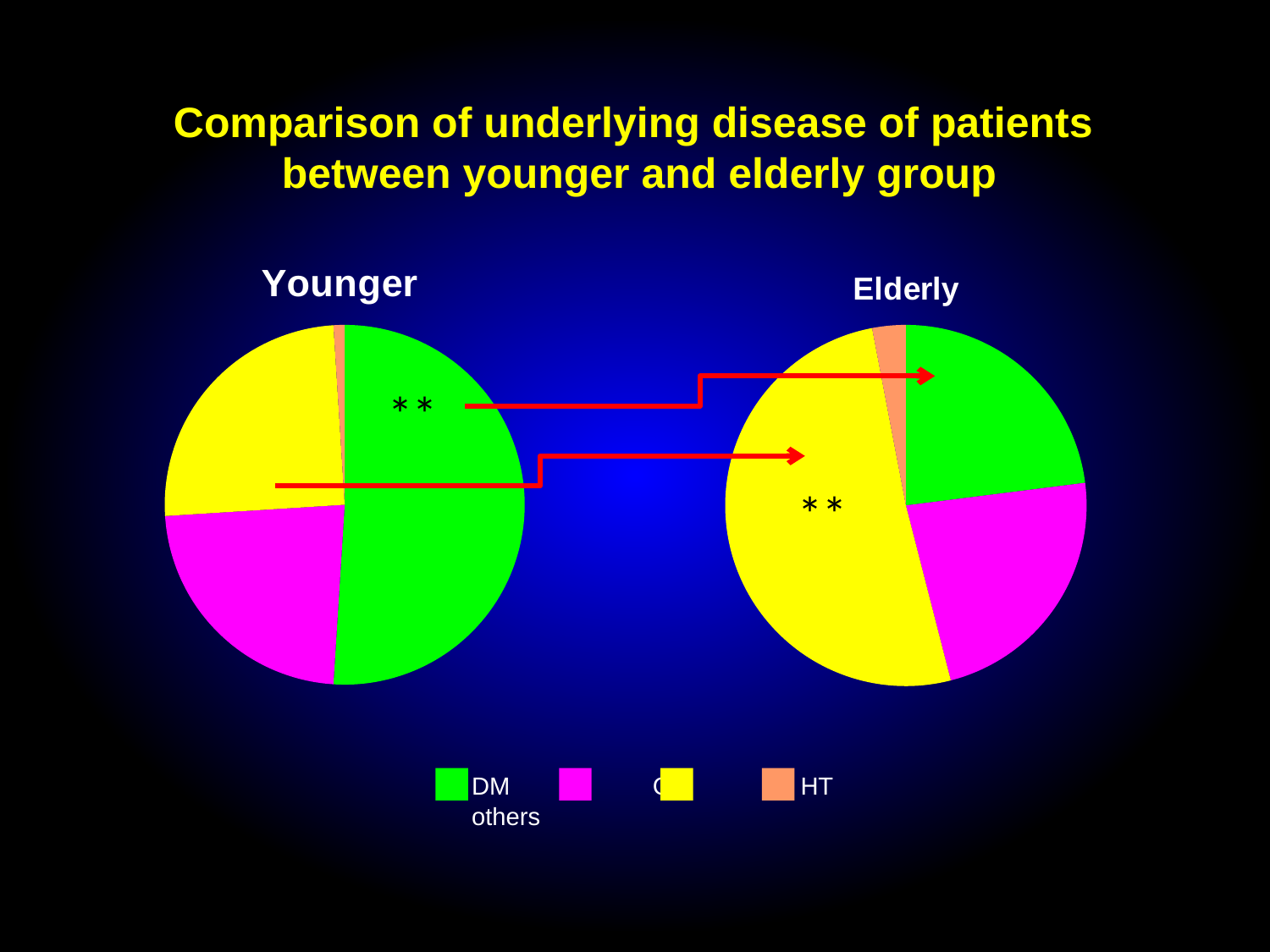
How many slices does the Younger pie chart have? 4 Is the DM slice larger in the Younger pie chart or in the Elderly pie chart? Younger In the Younger pie chart, which category has the largest slice? DM How many pie charts are shown on the slide? 2 In the Elderly pie chart, which colour slice is the largest? yellow What is the title of the slide containing the two pie charts? Comparison of underlying disease of patients between younger and elderly group What colour represents DM in the legend? green What kind of chart is used for the Younger group? pie chart How many slices does the Elderly pie chart have? 4 In the Younger pie chart, which is larger, the DM slice or the HT slice? DM